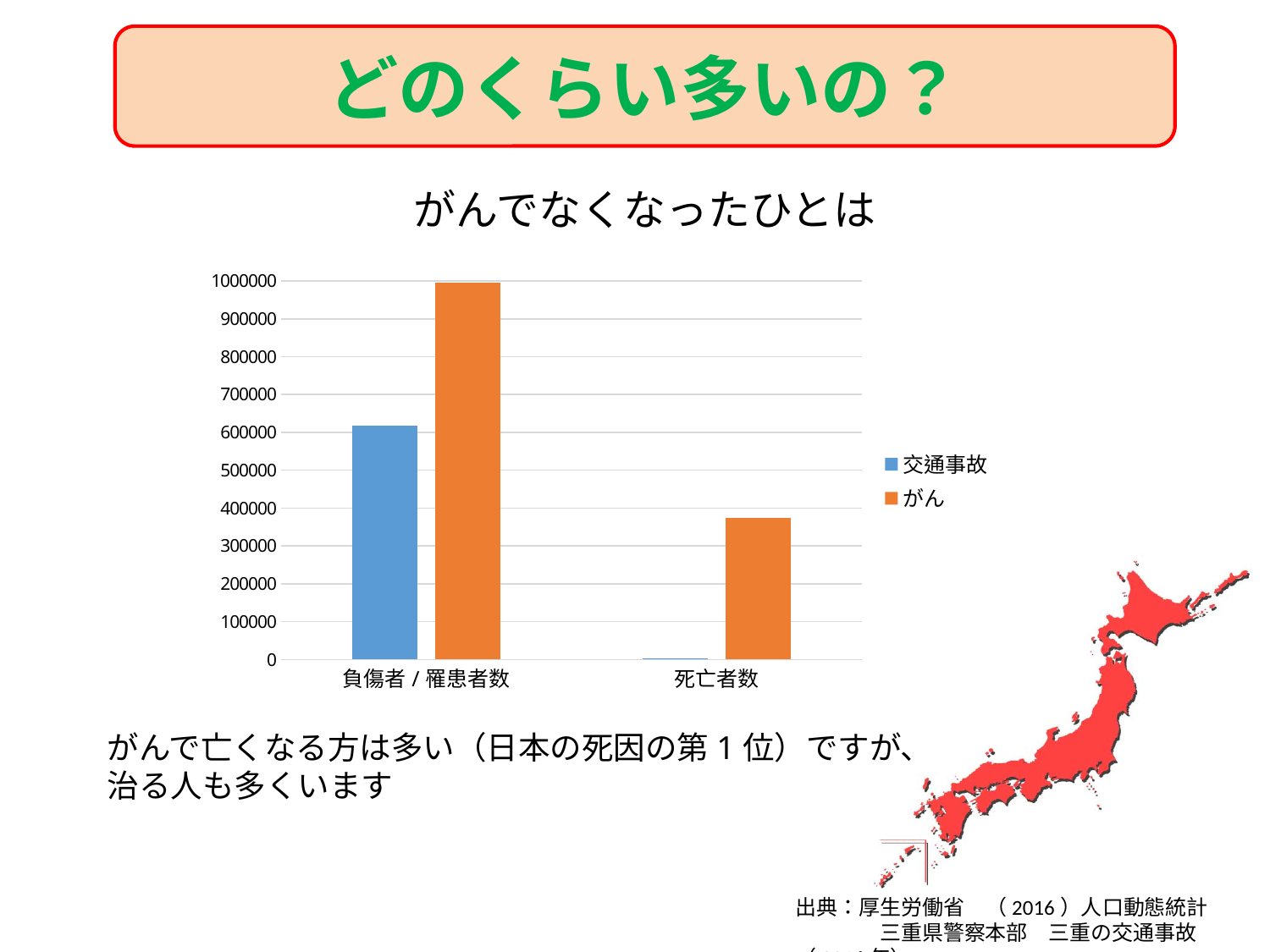
How many categories are shown on the x axis? 2 Is the value for がん in 死亡者数 greater or less than 400000? less Is the value for 交通事故 in 負傷者／罹患者数 greater or less than 500000? greater How many series does the legend list? 2 For 負傷者／罹患者数, which series has the larger value, 交通事故 or がん? がん Which bar is the lowest in the chart? 交通事故 for 死亡者数 What kind of chart is shown on the slide? bar chart Which colour represents the 交通事故 series in the chart? blue Which series has the highest bar in the chart? がん For 死亡者数, which series has the larger value, 交通事故 or がん? がん What is the title of the chart? がんでなくなったひとは Is the value for がん in 負傷者／罹患者数 greater or less than 900000? greater